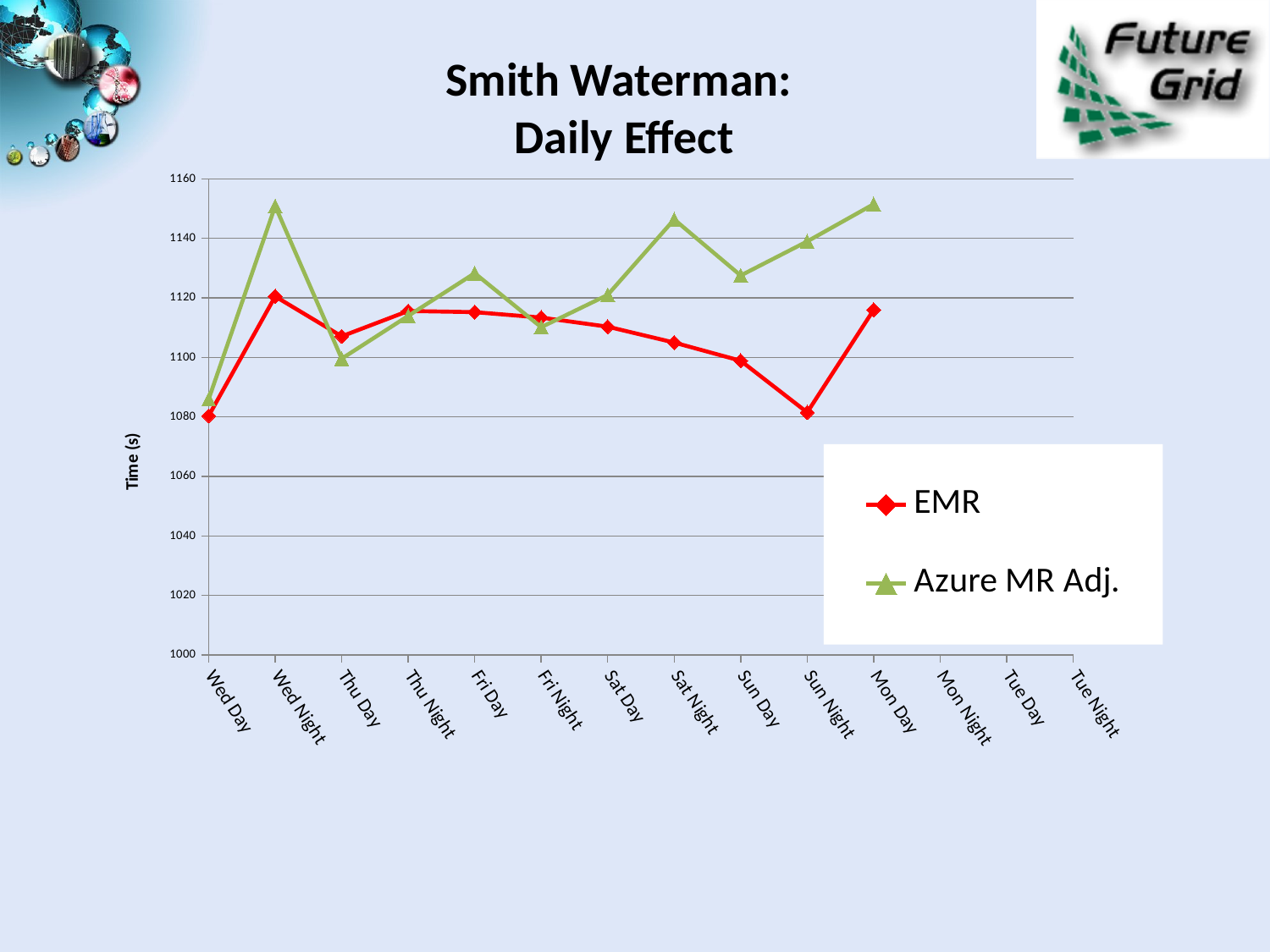
What is the label of the vertical axis? Time (s) How many series does the legend list? 2 How many data points are plotted for the EMR series? 11 Is the Azure MR Adj. value for Fri Day greater or less than 1120? greater Is the EMR value for Thu Day greater or less than 1100? greater Does the EMR series rise or fall from Thu Night to Sun Night? fall At Wed Night, which series has the higher value, EMR or Azure MR Adj.? Azure MR Adj. What kind of chart is shown on the slide? line chart What are the two series named in the legend? EMR and Azure MR Adj. Is the Azure MR Adj. value for Wed Night greater or less than 1140? greater At Sun Night, which series has the higher value, EMR or Azure MR Adj.? Azure MR Adj.